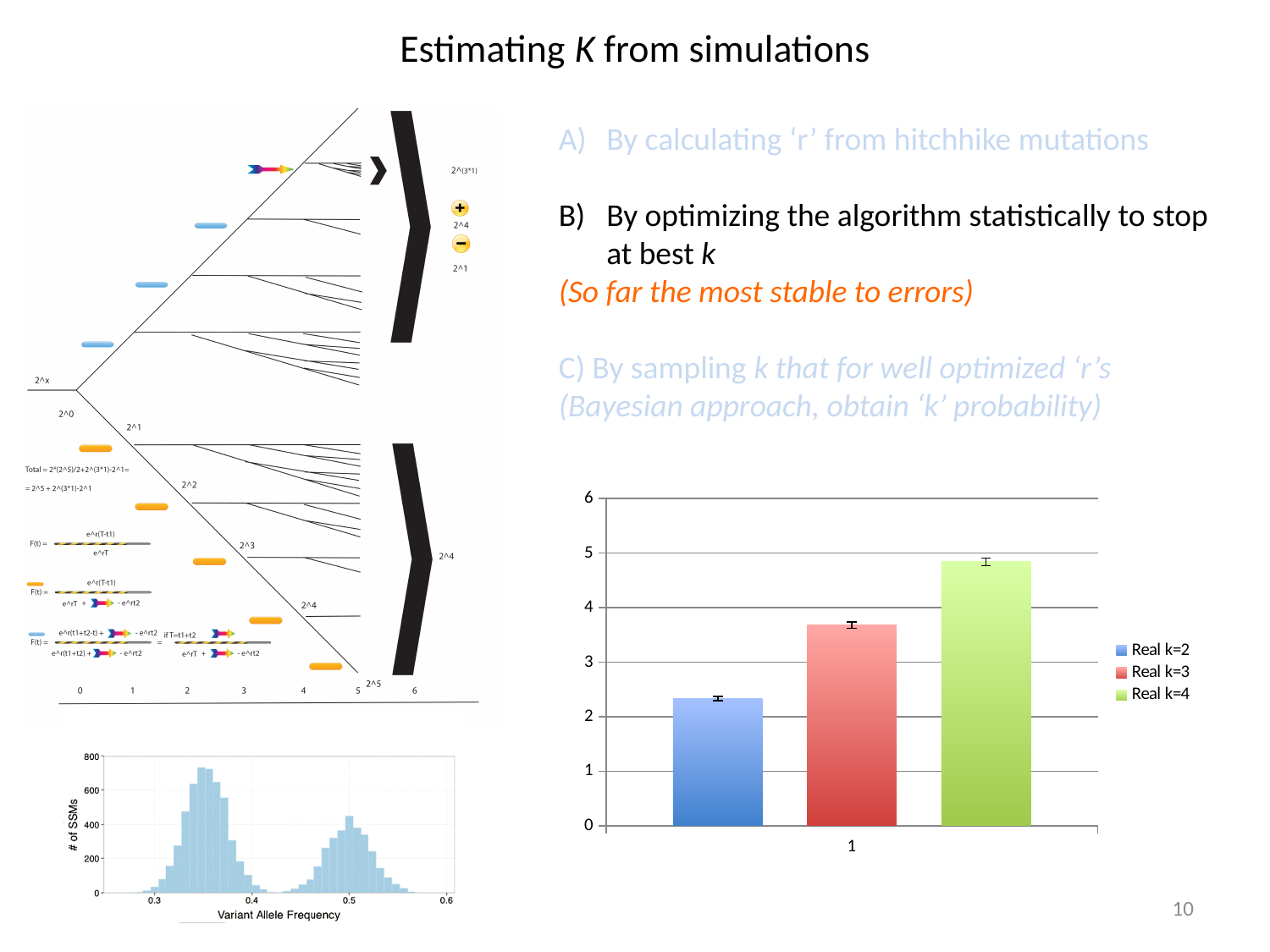
What kind of chart is the chart on the right side of the slide? bar chart In the histogram at the bottom left of the slide, what is the x-axis label? Variant Allele Frequency In the bar chart on the right, is the value for Real k=2 greater or less than 3? less In the bar chart on the right, is the value for Real k=3 greater or less than 3? greater In the bar chart on the right, how many series does the legend list? 3 In the bar chart on the right, is the value for Real k=4 greater or less than 4? greater In the bar chart on the right, which is larger: the bar for Real k=3 or the bar for Real k=2? Real k=3 In the bar chart on the right, what are the legend entries? Real k=2, Real k=3, Real k=4 In the bar chart on the right, which series has the highest bar? Real k=4 In the bar chart on the right, which series has the lowest bar? Real k=2 In the bar chart on the right, how many categories are shown on the x axis? 1